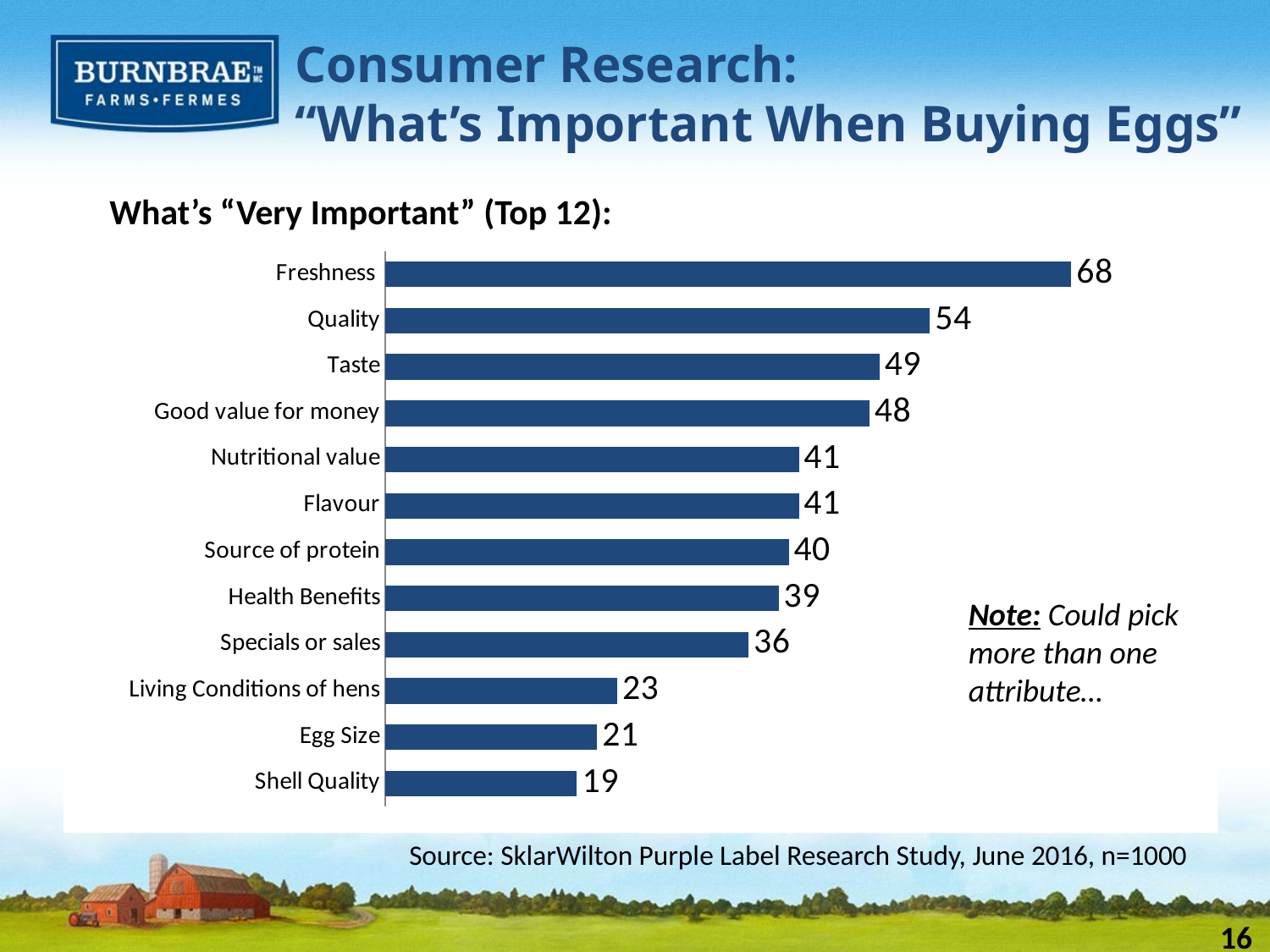
Which is larger, the value for Taste or the value for Health Benefits? Taste What is the value for Freshness? 68 What is the heading shown above the chart? What's "Very Important" (Top 12): What is the value for Living Conditions of hens? 23 Which two attributes both have a value of 41? Nutritional value and Flavour What is the difference between the values for Specials or sales and Egg Size? 15 What is the value for Good value for money? 48 Which attribute has the highest value? Freshness What is the difference between the values for Freshness and Quality? 14 How many attributes are shown in the chart? 12 Which attribute has the lowest value? Shell Quality What kind of chart is shown on the slide? Bar chart